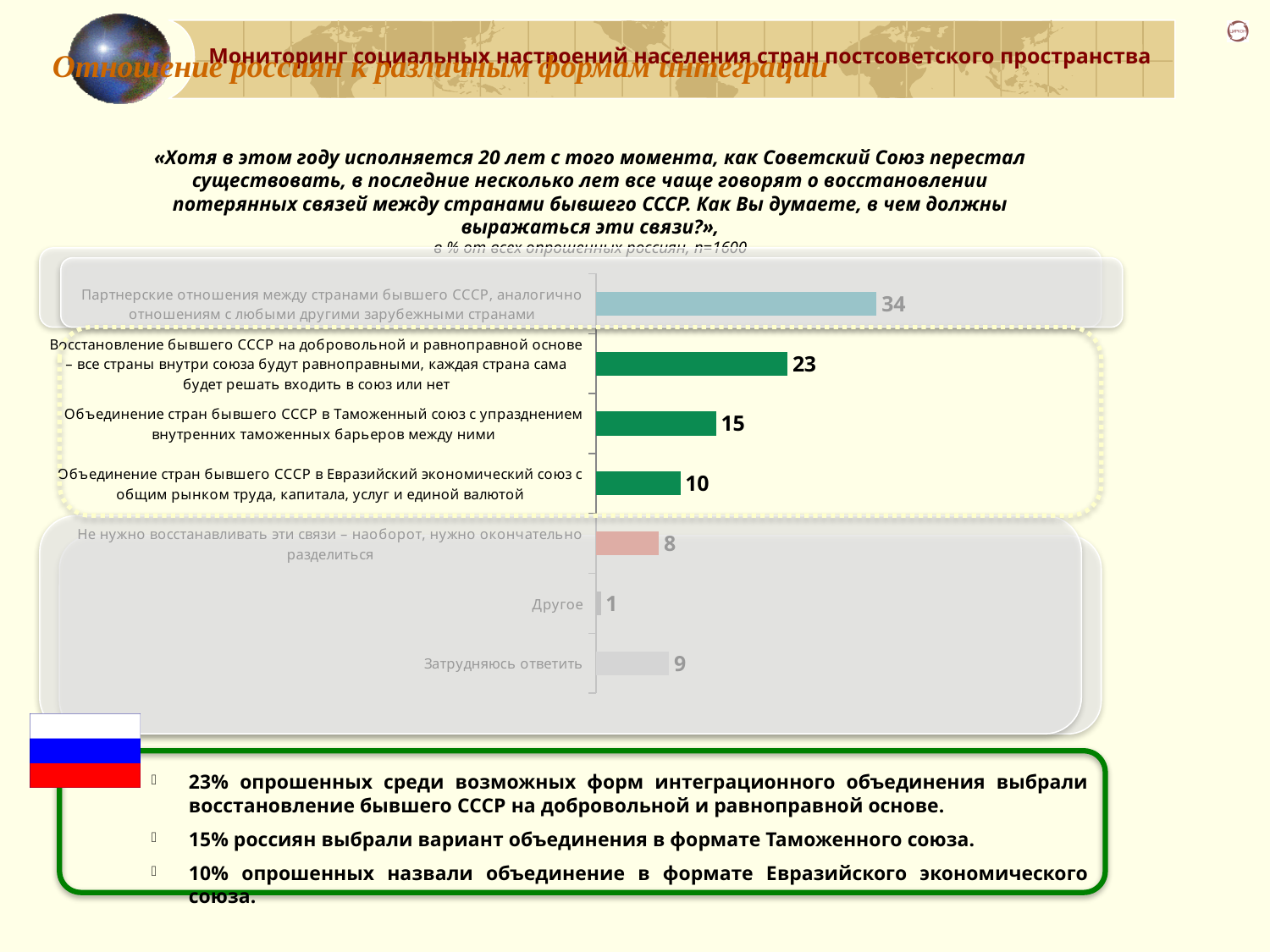
What kind of chart is shown on the slide? Bar chart What value is shown for «Не нужно восстанавливать эти связи – наоборот, нужно окончательно разделиться»? 8 What value is shown for «Партнерские отношения между странами бывшего СССР, аналогично отношениям с любыми другими зарубежными странами»? 34 Which category has the lowest value? Другое What value is shown for «Объединение стран бывшего СССР в Таможенный союз с упразднением внутренних таможенных барьеров между ними»? 15 What value is shown for «Затрудняюсь ответить»? 9 What is the difference between the value for «Восстановление бывшего СССР на добровольной и равноправной основе» and the value for «Объединение стран бывшего СССР в Евразийский экономический союз»? 13 Which category has the highest value? Партнерские отношения между странами бывшего СССР, аналогично отношениям с любыми другими зарубежными странами What is the difference between the value for «Партнерские отношения между странами бывшего СССР» and the value for «Восстановление бывшего СССР на добровольной и равноправной основе»? 11 What is the sample size (n) stated in the chart subtitle? n=1600 Which is larger: the value for «Затрудняюсь ответить» or the value for «Не нужно восстанавливать эти связи – наоборот, нужно окончательно разделиться»? Затрудняюсь ответить How many categories are shown in the chart? 7